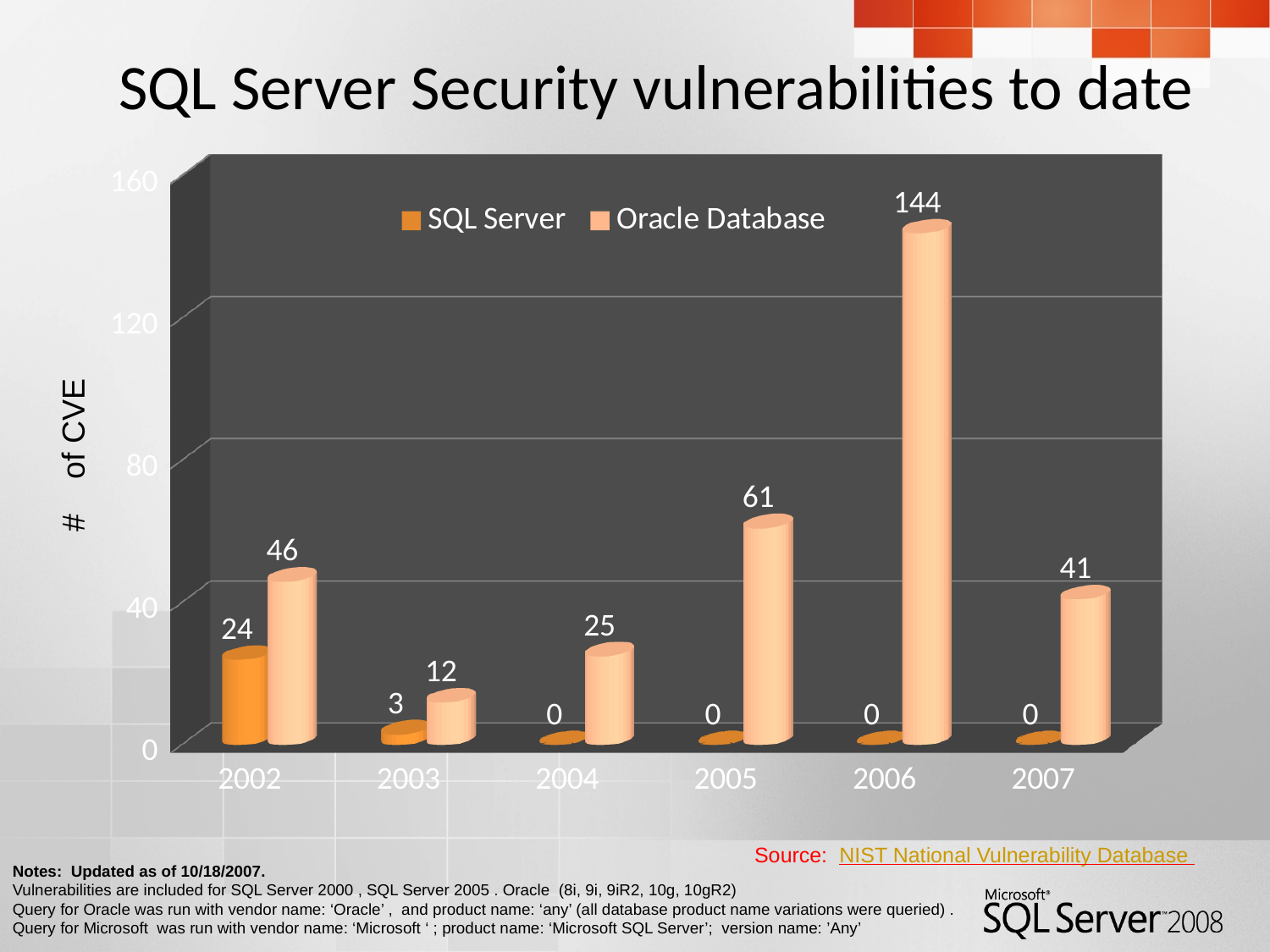
What is the number of CVEs for SQL Server in 2002? 24 In which year does Oracle Database have the lowest number of CVEs? 2003 What is the difference between the Oracle Database and SQL Server values in 2002? 22 What kind of chart is shown on the slide? Bar chart How many series does the legend list? 2 How many years are shown on the x axis? 6 What is the number of CVEs for Oracle Database in 2006? 144 What is the label of the vertical axis? # of CVE Is the value for Oracle Database in 2007 greater or less than 40? greater In which year does Oracle Database have the highest number of CVEs? 2006 What is the number of CVEs for Oracle Database in 2005? 61 Which has more CVEs in 2003, SQL Server or Oracle Database? Oracle Database